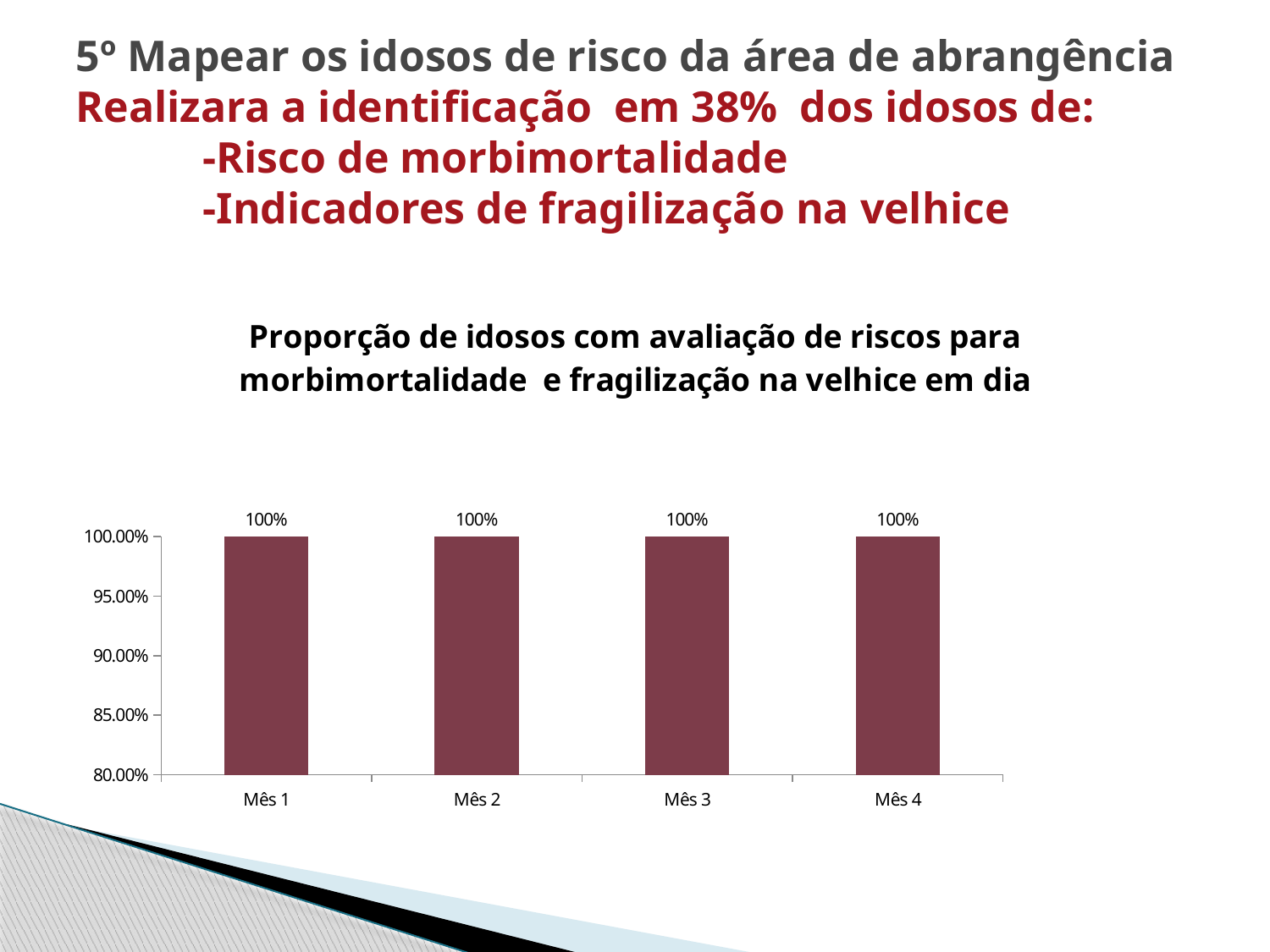
What is the difference between the values for Mês 1 and Mês 4? 0% What is the value for Mês 3? 100% Is the value for Mês 2 greater or less than 90.00%? greater What is the lowest value shown on the y axis of the chart? 80.00% What kind of chart is shown on the slide? bar chart What is the value for Mês 4? 100% Do the values rise, fall or stay the same from Mês 1 to Mês 4? stay the same What is the title of the chart? Proporção de idosos com avaliação de riscos para morbimortalidade e fragilização na velhice em dia What is the value for Mês 2? 100% How many categories are shown on the x axis of the chart? 4 What is the value for Mês 1? 100%